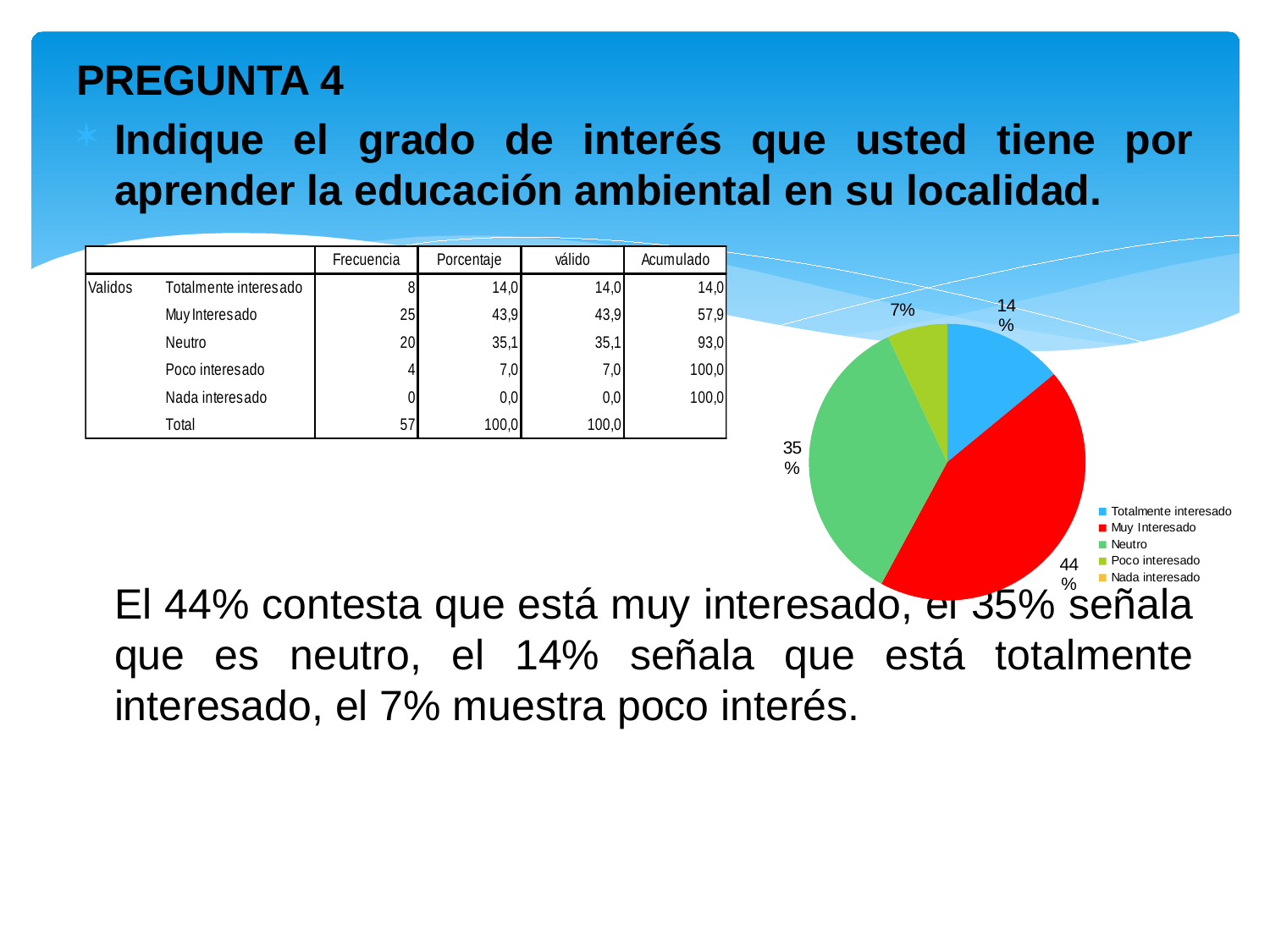
Which category has the largest slice in the pie chart? Muy Interesado What kind of chart is shown on the slide? pie chart Which is larger in the pie chart, Totalmente interesado or Neutro? Neutro What percentage does the pie chart show for Neutro? 35% How many categories does the legend of the pie chart list? 5 What percentage does the pie chart show for Totalmente interesado? 14% Which of the slices visible in the pie chart is the smallest? Poco interesado By how many percentage points does Muy Interesado exceed Neutro in the pie chart? 9 What colour is the Neutro slice in the pie chart? green What percentage does the pie chart show for Muy Interesado? 44% What percentage does the pie chart show for Poco interesado? 7% What colour is the Muy Interesado slice in the pie chart? red